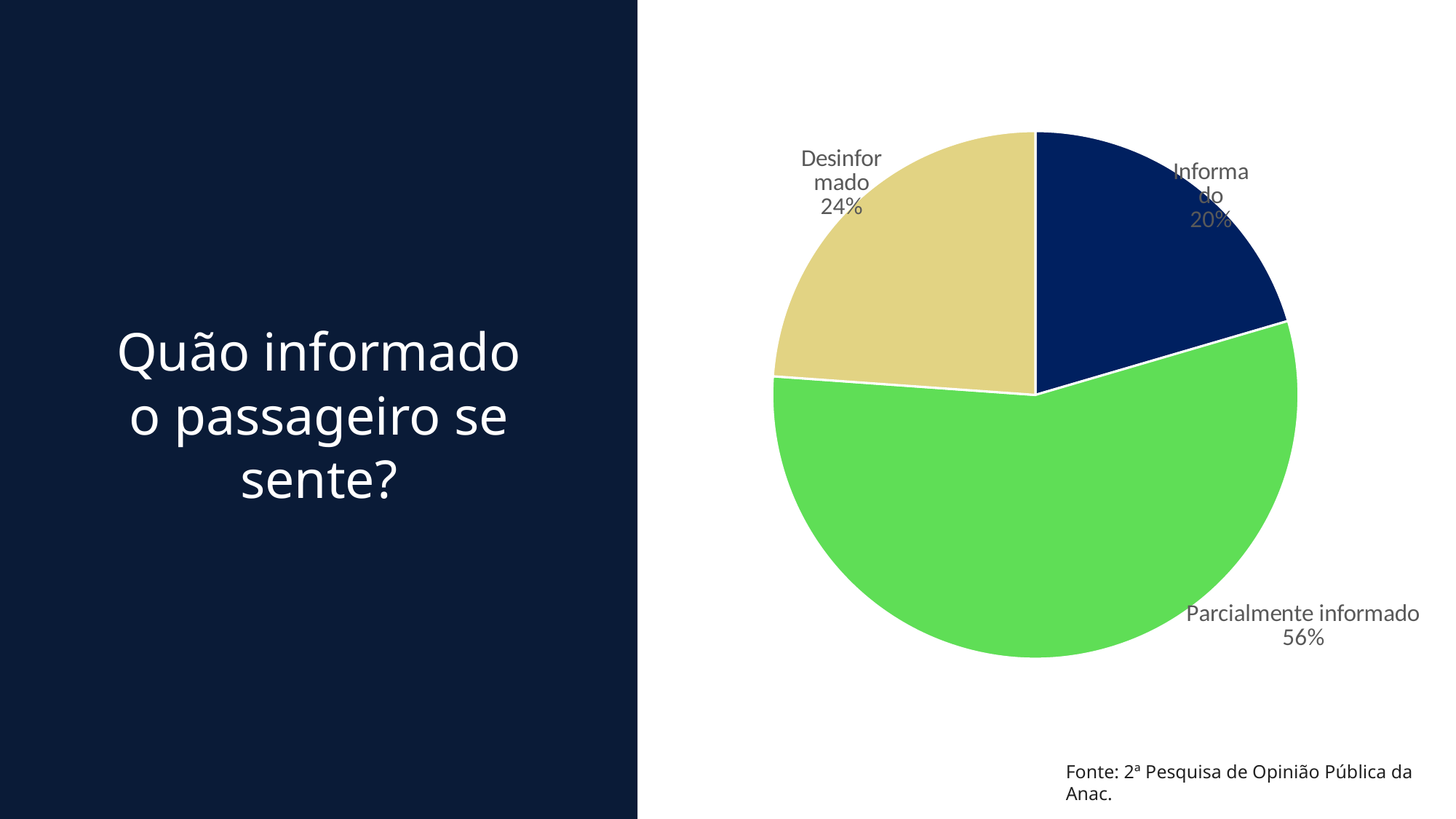
What percentage of passengers are 'Parcialmente informado'? 56% What is the difference in percentage points between 'Parcialmente informado' and 'Desinformado'? 32 Which category has the smallest share of the pie? Informado Which is larger, the share for 'Desinformado' or the share for 'Informado'? Desinformado How many slices does the pie chart have? 3 What percentage of passengers are 'Informado'? 20% What colour is the 'Parcialmente informado' slice? green What is the source cited for the chart data? 2ª Pesquisa de Opinião Pública da Anac What is the difference in percentage points between 'Desinformado' and 'Informado'? 4 What kind of chart is shown on the slide? pie chart What percentage of passengers are 'Desinformado'? 24% Which category has the largest share of the pie? Parcialmente informado